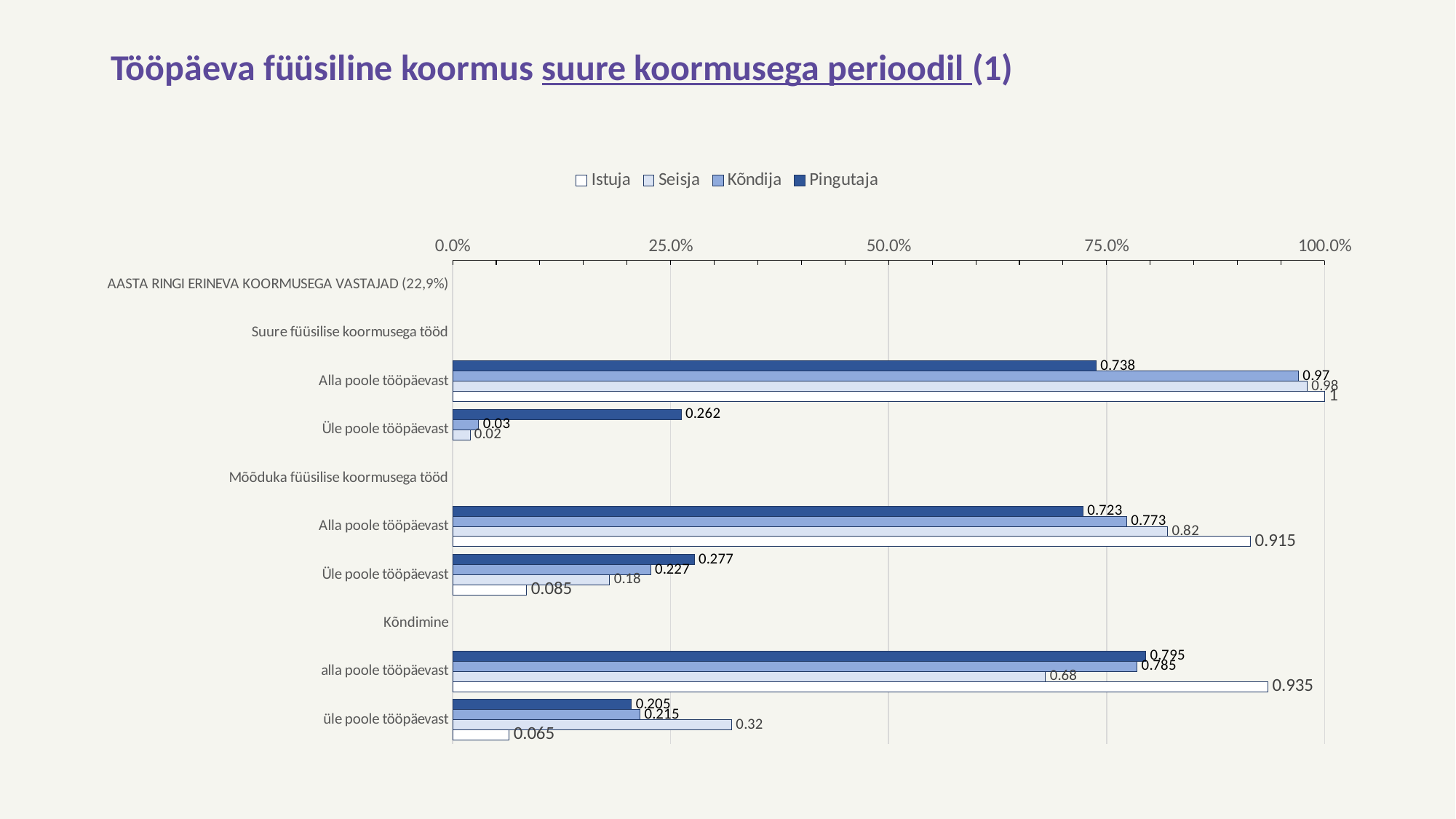
Which series is shown in the darkest blue in the legend? Pingutaja What type of chart is shown on the slide? bar chart In the 'üle poole tööpäevast' row under 'Kõndimine', which is larger: the Seisja value or the Pingutaja value? Seisja What is the value for Istuja in the 'Alla poole tööpäevast' row under 'Mõõduka füüsilise koormusega tööd'? 0.915 What is the value for Pingutaja in the 'Üle poole tööpäevast' row under 'Suure füüsilise koormusega tööd'? 0.262 What is the value for Kõndija in the 'Alla poole tööpäevast' row under 'Suure füüsilise koormusega tööd'? 0.97 Which series has the highest value in the 'alla poole tööpäevast' row under 'Kõndimine'? Istuja What is the value for Seisja in the 'üle poole tööpäevast' row under 'Kõndimine'? 0.32 What is the difference between the Istuja and Pingutaja values in the 'Alla poole tööpäevast' row under 'Mõõduka füüsilise koormusega tööd'? 0.192 Is the Pingutaja value in the 'Alla poole tööpäevast' row under 'Suure füüsilise koormusega tööd' greater or less than 50.0%? greater How many series does the legend list? 4 Which series has the lowest value in the 'Üle poole tööpäevast' row under 'Mõõduka füüsilise koormusega tööd'? Istuja